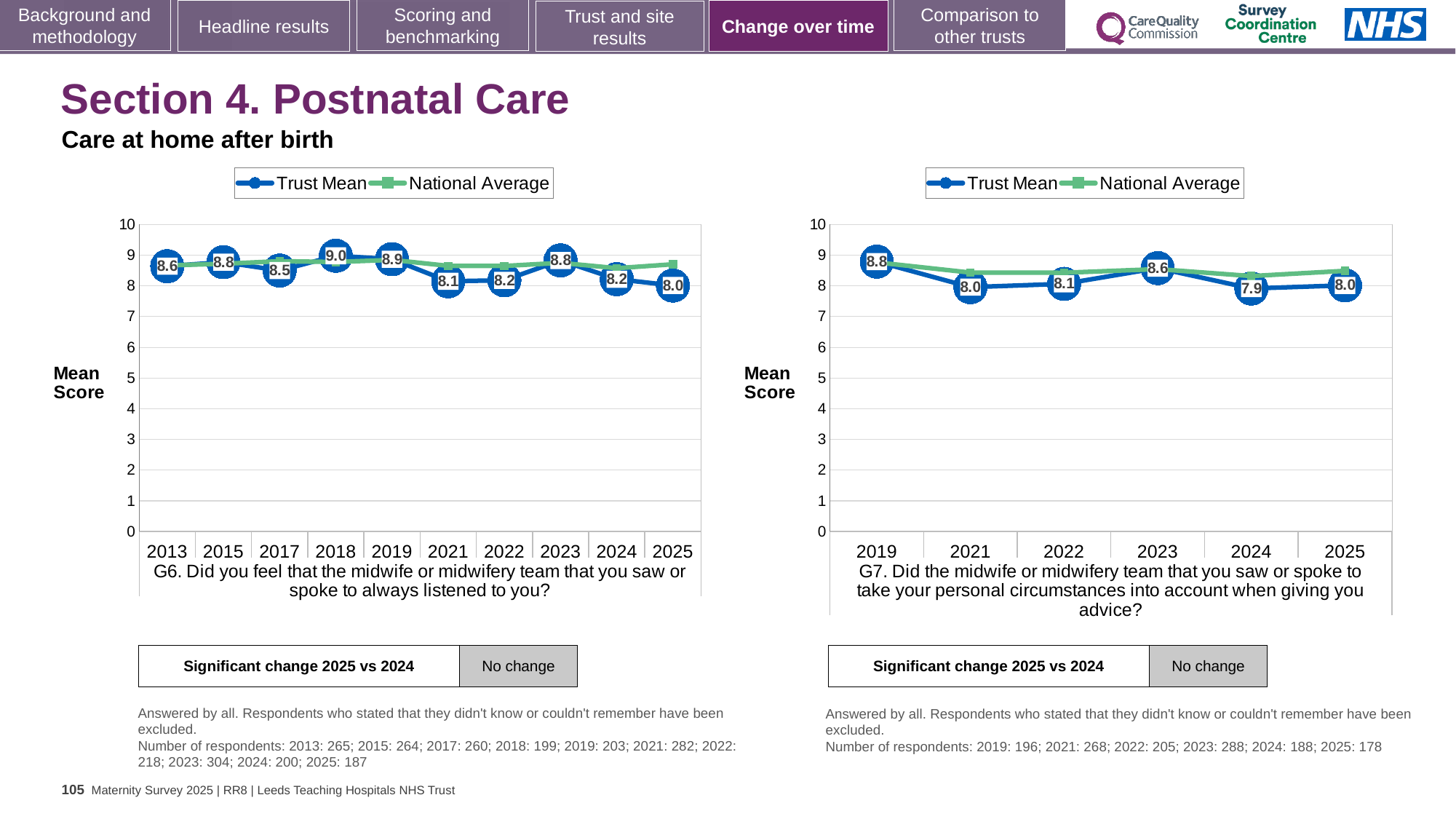
In the G6 chart on the left, what is the Trust Mean score for 2018? 9.0 How many series does the legend of the G7 chart on the right list? 2 In the G7 chart on the right, which year has the lowest Trust Mean score? 2024 In the G7 chart on the right, what is the Trust Mean score for 2024? 7.9 In the G6 chart on the left, is the Trust Mean score higher in 2023 or in 2024? 2023 In the G7 chart on the right, what is the difference between the Trust Mean scores for 2019 and 2021? 0.8 What type of chart is the G7 chart on the right? Line chart In the G6 chart on the left, what is the Trust Mean score for 2025? 8.0 In the G7 chart on the right, which year has the highest Trust Mean score? 2019 In the G6 chart on the left, what is the difference between the Trust Mean scores for 2018 and 2025? 1.0 In the G6 chart on the left, which year has the highest Trust Mean score? 2018 How many years are plotted on the x axis of the G6 chart on the left? 10